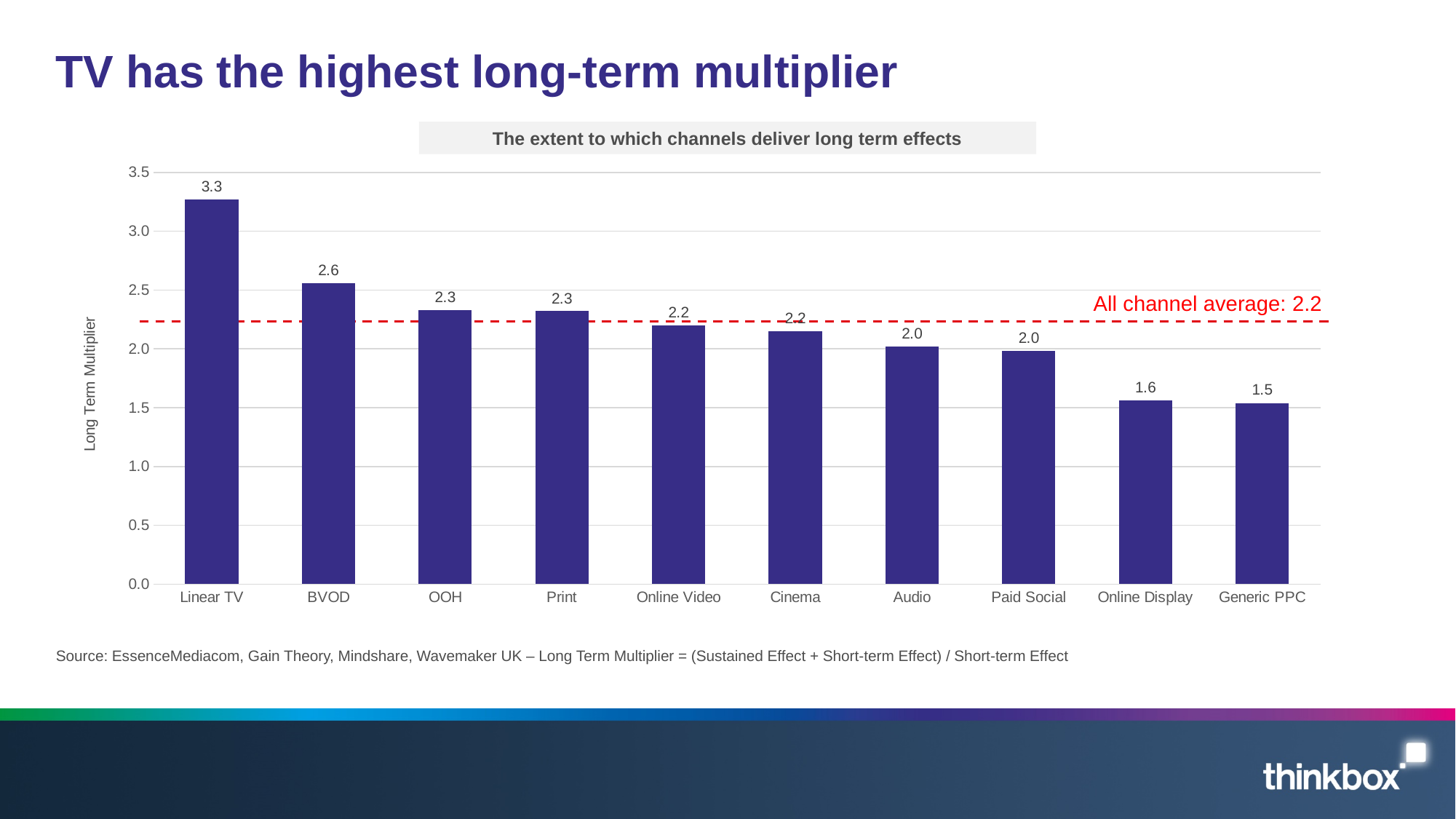
What is the long term multiplier for Online Display? 1.6 What kind of chart is shown on the slide? Bar chart What is the difference between the long term multiplier for Linear TV and for BVOD? 0.7 What is the long term multiplier for Generic PPC? 1.5 Which channel has the lowest long term multiplier? Generic PPC What is the long term multiplier for BVOD? 2.6 What is the long term multiplier for Linear TV? 3.3 Is the value for Paid Social greater or less than 2.5? less What is the all channel average shown by the dashed red line? 2.2 Which channel has the highest long term multiplier? Linear TV Which has a higher long term multiplier, BVOD or Audio? BVOD How many channels are shown on the chart? 10